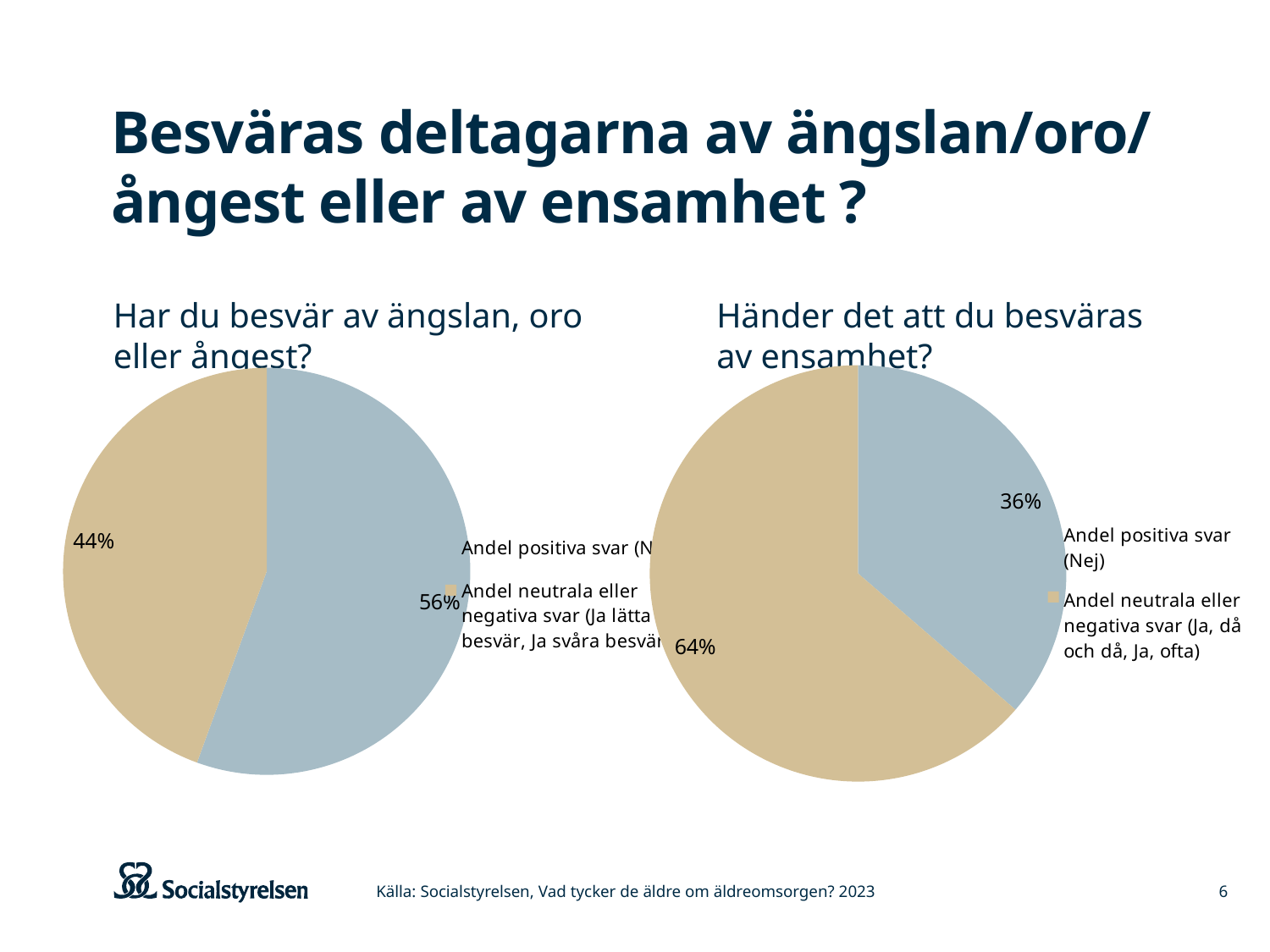
What kind of chart is used for "Har du besvär av ängslan, oro eller ångest?"? Pie chart In the chart "Händer det att du besväras av ensamhet?", what is the difference in percentage points between the neutral/negative slice and the positive (Nej) slice? 28 percentage points In the chart "Har du besvär av ängslan, oro eller ångest?", which slice is the smallest? Andel neutrala eller negativa svar In the chart "Händer det att du besväras av ensamhet?", what share is labelled for the positive answers (Nej) slice? 36% In the chart "Har du besvär av ängslan, oro eller ångest?", what share is labelled for the positive answers (Nej) slice? 56% Which chart has the larger share of positive answers (Nej): "Har du besvär av ängslan, oro eller ångest?" or "Händer det att du besväras av ensamhet?"? Har du besvär av ängslan, oro eller ångest? In the chart "Har du besvär av ängslan, oro eller ångest?", what is the difference in percentage points between the positive (Nej) slice and the neutral/negative slice? 12 percentage points In the chart "Händer det att du besväras av ensamhet?", what share is labelled for the neutral or negative answers slice? 64% In the chart "Har du besvär av ängslan, oro eller ångest?", what share is labelled for the neutral or negative answers slice? 44% In the chart "Händer det att du besväras av ensamhet?", which slice is the largest? Andel neutrala eller negativa svar (Ja, då och då, Ja, ofta) How many pie charts are shown on the slide? 2 How many slices does the chart "Händer det att du besväras av ensamhet?" have? 2